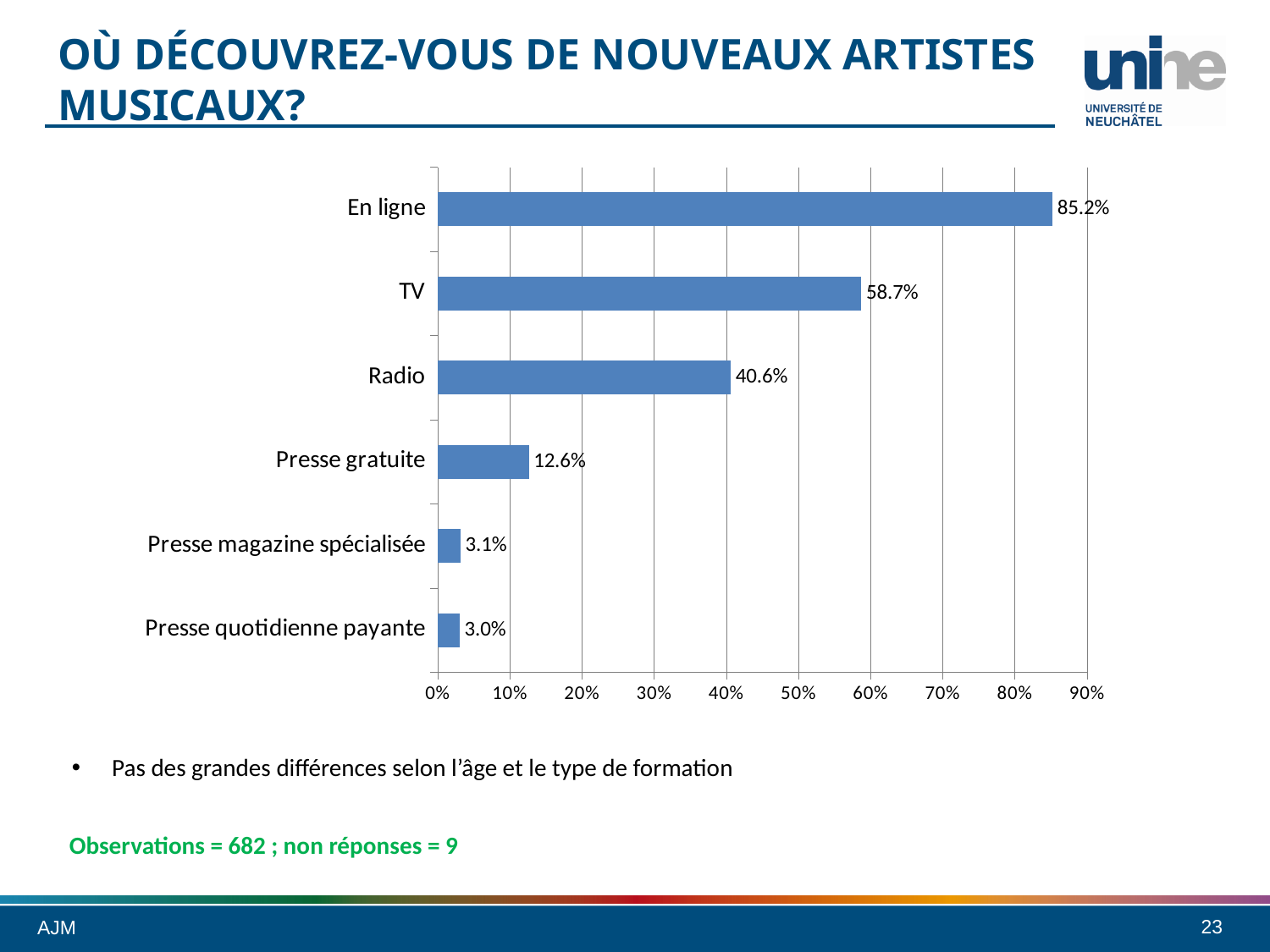
What kind of chart is shown on the slide? bar chart What is the value for Presse quotidienne payante? 3.0% What is the value for Radio? 40.6% How many categories are shown in the chart? 6 Which category has the lowest value? Presse quotidienne payante What is the difference between the values for En ligne and TV? 26.5% Is the value for TV greater or less than 50%? greater Which is larger, the value for TV or the value for Radio? TV Which category has the highest value? En ligne What is the value for Presse gratuite? 12.6% What is the difference between the values for Radio and Presse gratuite? 28.0% What is the value for En ligne? 85.2%